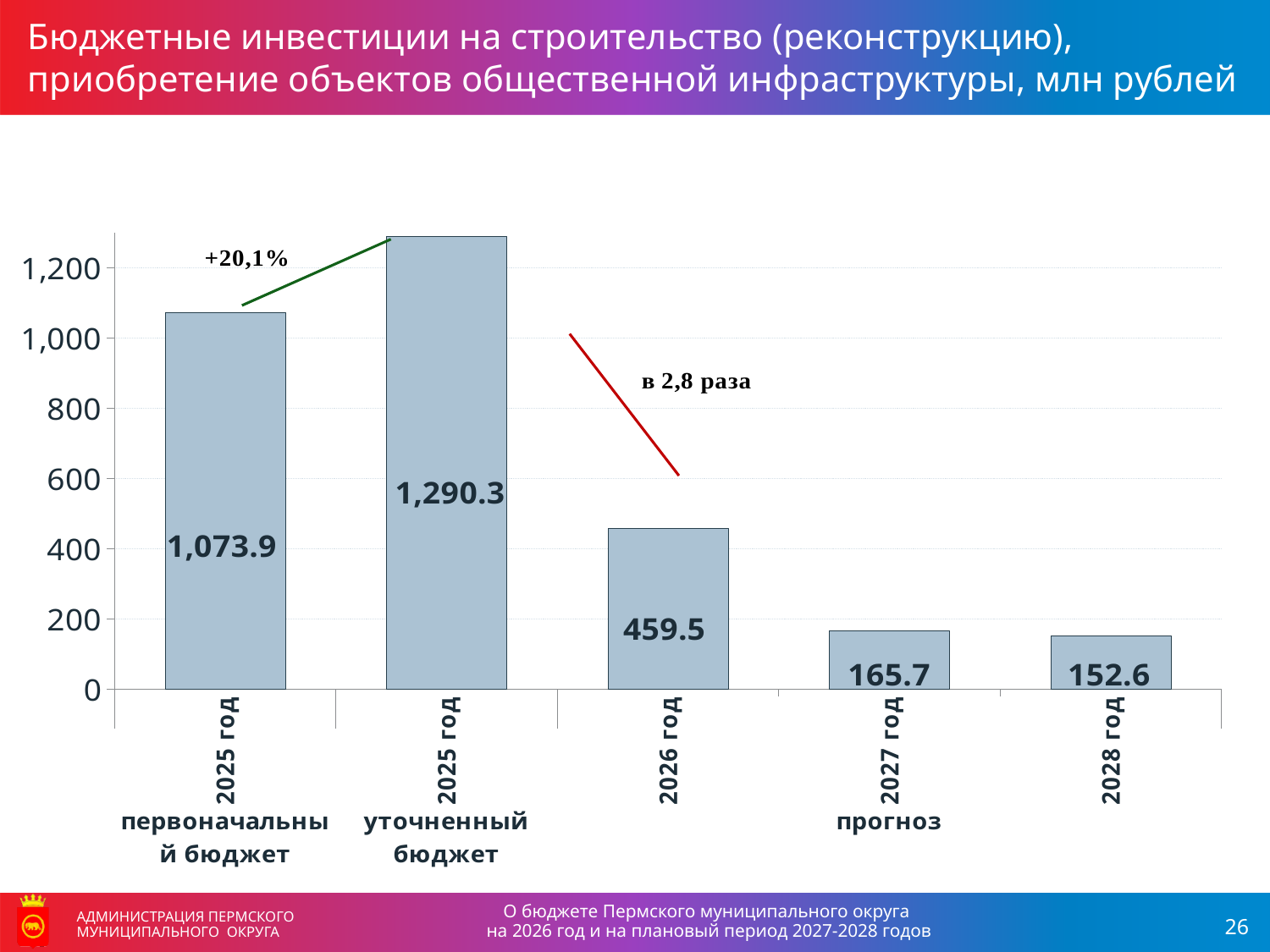
What is the difference between the 2025 год уточненный бюджет value and the 2025 год первоначальный бюджет value? 216.4 Which is larger, the value for 2026 год or the value for 2027 год? 2026 год Which bar has the lowest value? 2028 год What percentage change is annotated between the two 2025 год bars? +20,1% Do the values rise or fall from 2026 год to 2028 год? fall What is the value for 2028 год? 152.6 How many bars are plotted in the chart? 5 What is the value for the 2025 год уточненный бюджет bar? 1,290.3 What is the value for the 2025 год первоначальный бюджет bar? 1,073.9 What is the value for 2026 год? 459.5 Which bar has the highest value? 2025 год уточненный бюджет What type of chart is shown on the slide? bar chart